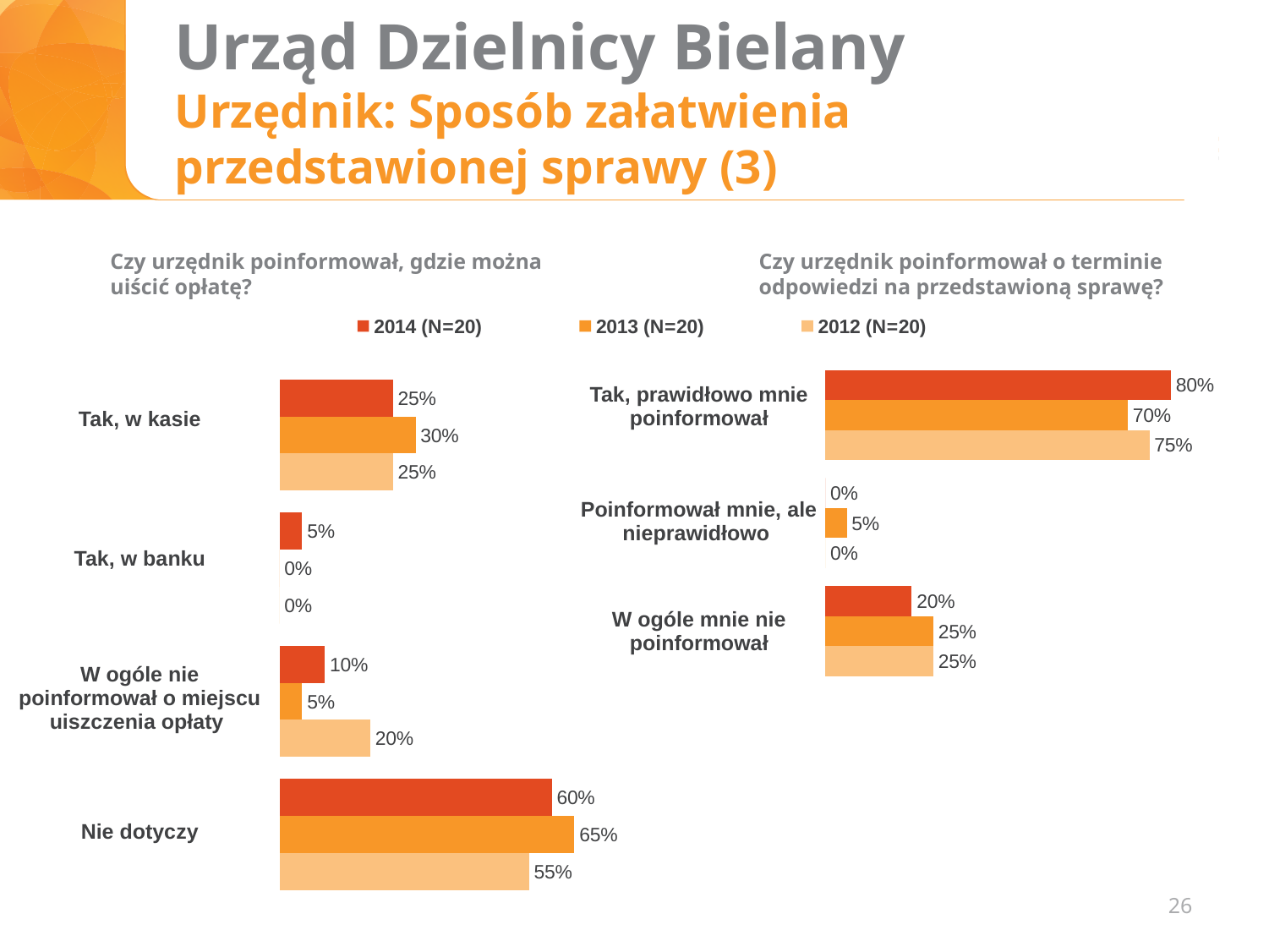
How many series does the legend list for the charts on this slide? 3 In the left chart ('Czy urzędnik poinformował, gdzie można uiścić opłatę?'), what is the value for 'Tak, w banku' in 2014 (N=20)? 5% In the right chart ('Czy urzędnik poinformował o terminie odpowiedzi na przedstawioną sprawę?'), what is the value for 'Tak, prawidłowo mnie poinformował' in 2014 (N=20)? 80% In the left chart ('Czy urzędnik poinformował, gdzie można uiścić opłatę?'), which is larger for 'W ogóle nie poinformował o miejscu uiszczenia opłaty': the 2014 (N=20) value or the 2012 (N=20) value? 2012 (N=20) In the right chart ('Czy urzędnik poinformował o terminie odpowiedzi na przedstawioną sprawę?'), which category has the lowest value for 2012 (N=20)? Poinformował mnie, ale nieprawidłowo In the left chart ('Czy urzędnik poinformował, gdzie można uiścić opłatę?'), what is the value for 'Tak, w kasie' in 2013 (N=20)? 30% In the right chart ('Czy urzędnik poinformował o terminie odpowiedzi na przedstawioną sprawę?'), what is the value for 'Poinformował mnie, ale nieprawidłowo' in 2013 (N=20)? 5% What kind of chart is the right chart ('Czy urzędnik poinformował o terminie odpowiedzi na przedstawioną sprawę?')? Bar chart How many categories does the left chart ('Czy urzędnik poinformował, gdzie można uiścić opłatę?') show? 4 In the right chart ('Czy urzędnik poinformował o terminie odpowiedzi na przedstawioną sprawę?'), what is the difference between the 2014 (N=20) and 2013 (N=20) values for 'Tak, prawidłowo mnie poinformował'? 10% In the left chart ('Czy urzędnik poinformował, gdzie można uiścić opłatę?'), what is the value for 'Nie dotyczy' in 2012 (N=20)? 55% In the left chart ('Czy urzędnik poinformował, gdzie można uiścić opłatę?'), which category has the highest value for 2014 (N=20)? Nie dotyczy